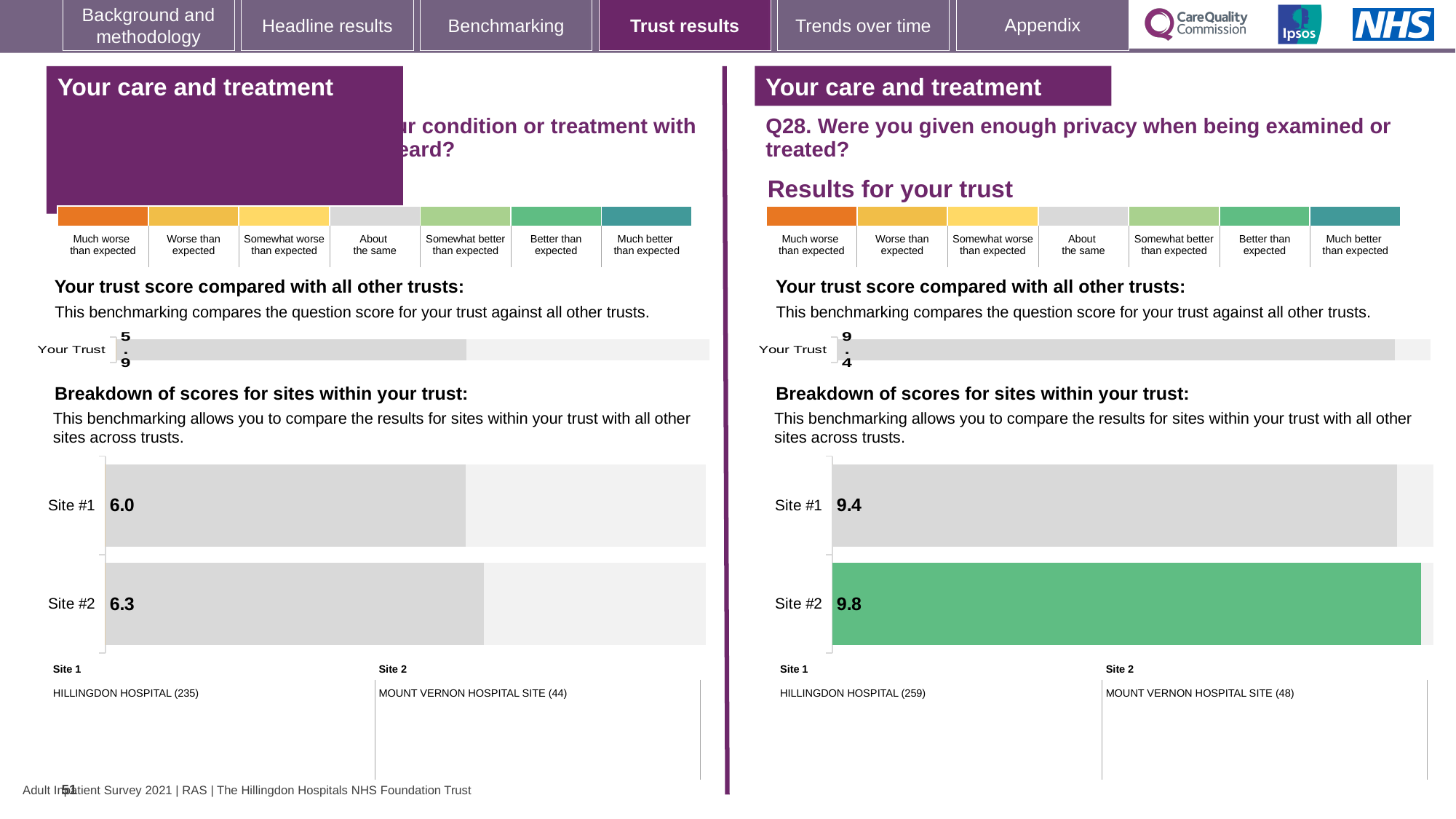
On the right-hand chart for Q28, what is the score for Site #2? 9.8 How many sites are shown in the right-hand site breakdown chart for Q28? 2 On the right-hand chart for Q28 (privacy when being examined or treated), what is the score for Site #1? 9.4 On the left-hand 'Your trust score compared with all other trusts' chart, what is the score shown for Your Trust? 5.9 On the right-hand 'Your trust score compared with all other trusts' chart for Q28, what is the score shown for Your Trust? 9.4 What type of chart is used for the site breakdown on the right-hand side for Q28? Bar chart On the right-hand site breakdown chart for Q28, what is the difference between the Site #2 and Site #1 scores? 0.4 On the left-hand site breakdown chart, what is the difference between the Site #2 and Site #1 scores? 0.3 On the left-hand site breakdown chart, what is the score for Site #1? 6.0 On the left-hand site breakdown chart, which site has the lower score? Site #1 On the right-hand site breakdown chart for Q28, which site has the higher score? Site #2 On the left-hand site breakdown chart, what is the score for Site #2? 6.3